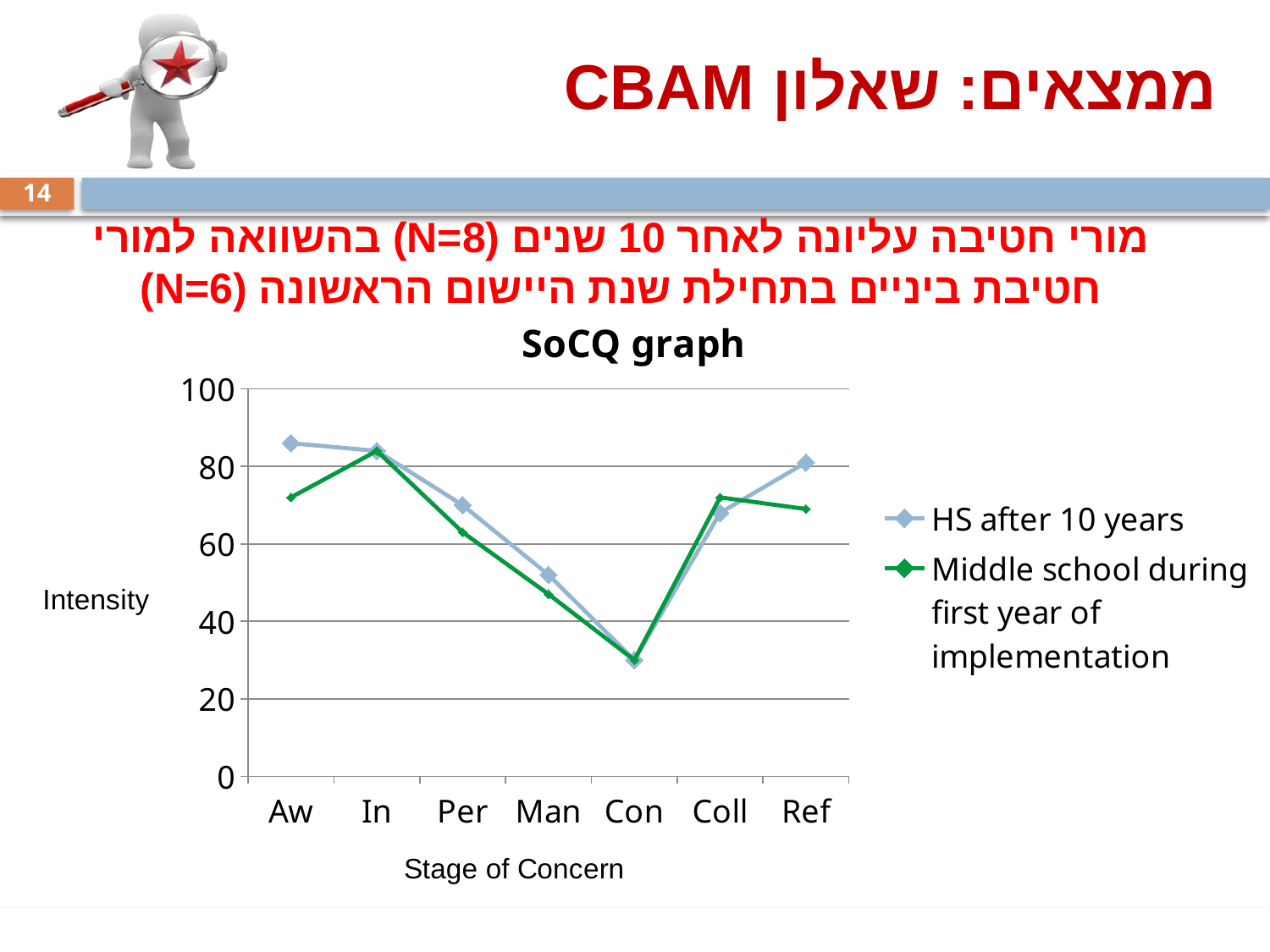
At which stage of concern is the value for HS after 10 years lowest? Con How many series does the legend of the SoCQ graph list? 2 Is the value for HS after 10 years at Aw greater or less than 80? greater Do the values for HS after 10 years rise or fall from In to Con? fall Is the value for HS after 10 years at Man greater or less than 60? less How many stages of concern are shown on the x axis of the SoCQ graph? 7 What is the title of the chart? SoCQ graph At which stage of concern is the value for Middle school during first year of implementation highest? In Which series has the higher value at Ref? HS after 10 years What kind of chart is the SoCQ graph? line chart What is the label of the vertical axis of the chart? Intensity Is the value for Middle school during first year of implementation at Aw greater or less than 80? less